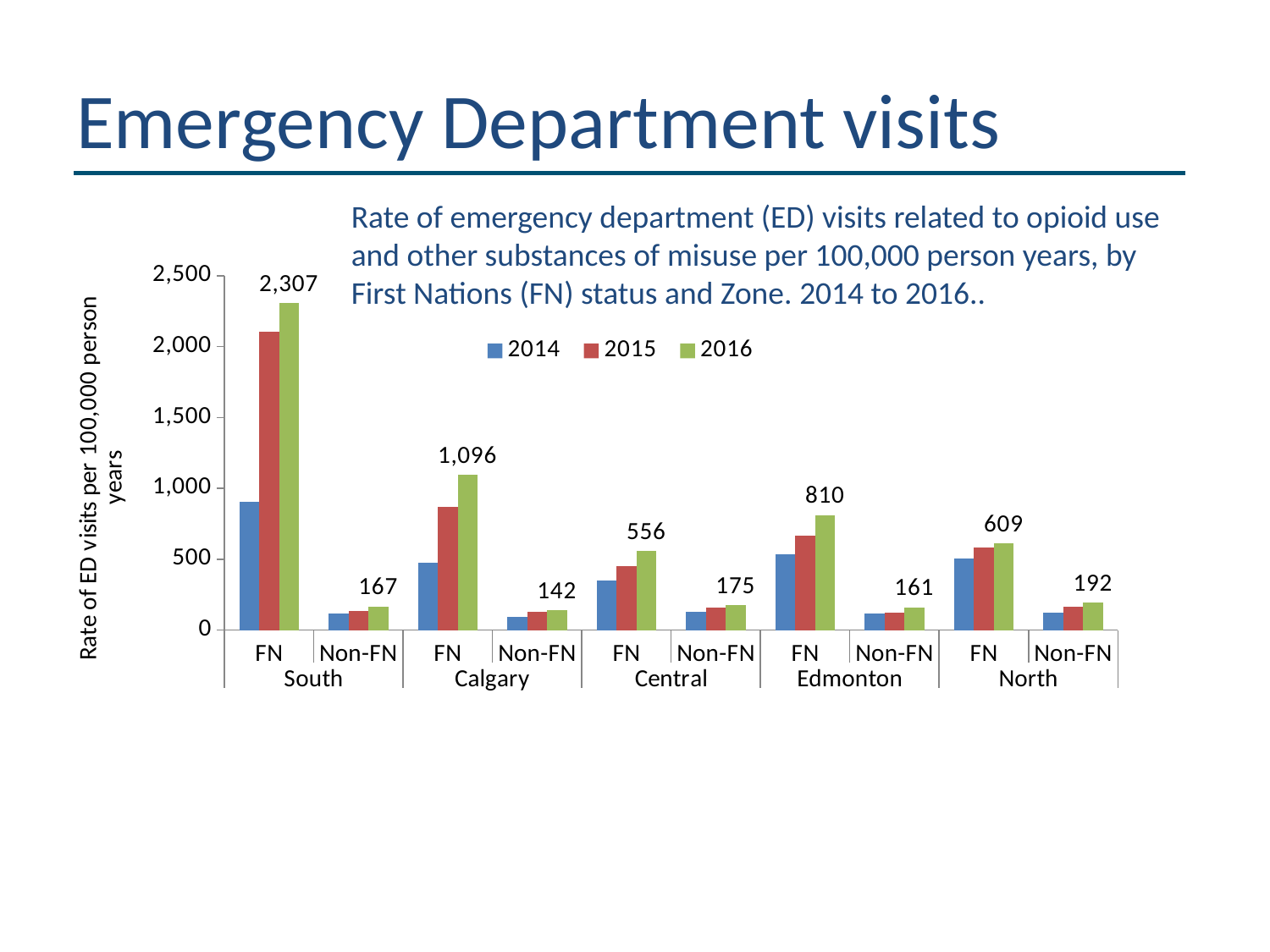
How many series does the legend list? 3 Which zone and status group has the highest 2016 rate of ED visits? South FN What is the 2016 rate of ED visits for FN in the Edmonton zone? 810 Which zone has the lowest 2016 rate of ED visits among Non-FN groups? Calgary Is the 2014 rate of ED visits for FN in the South zone greater or less than 1,000? less What is the 2016 rate of ED visits for Non-FN in the North zone? 192 What is the 2016 rate of ED visits for FN in the South zone? 2,307 Which is larger in 2016: the FN rate in Edmonton or the FN rate in North? Edmonton For FN in the Calgary zone, do the rates rise or fall from 2014 to 2016? Rise What kind of chart is shown on the slide? Bar chart What is the difference between the 2016 FN rate and the 2016 Non-FN rate in the Central zone? 381 What is the 2016 rate of ED visits for Non-FN in the Calgary zone? 142